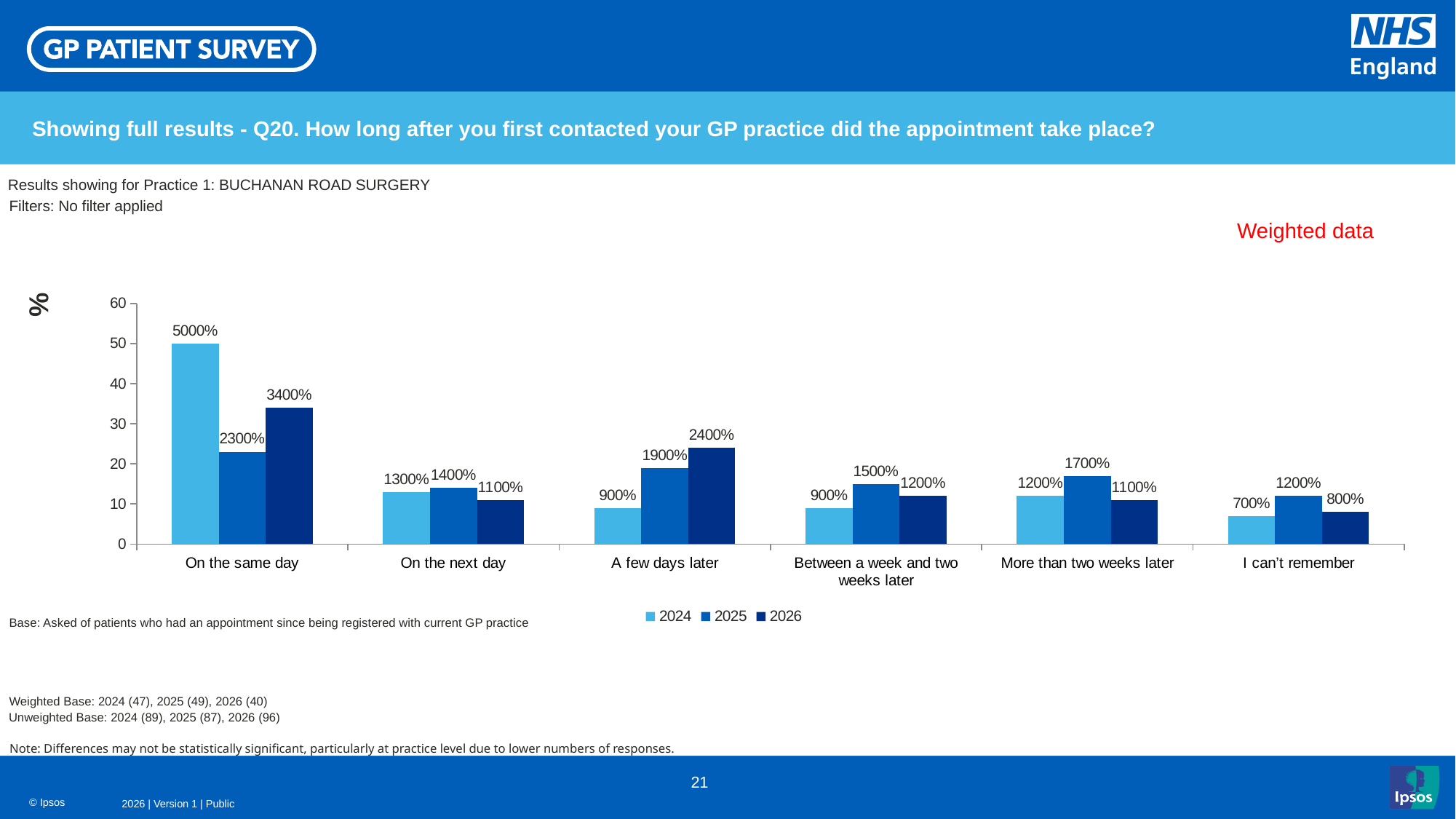
How many categories are shown on the x axis? 6 What are the legend entries of the chart? 2024, 2025, 2026 Which is larger for 'A few days later': the 2024 value or the 2025 value? 2025 What is the 2024 value for 'On the same day'? 5000% What is the 2025 value for 'More than two weeks later'? 1700% What is the 2026 value for 'A few days later'? 2400% Which category has the highest 2024 value? On the same day Which category has the lowest 2026 value? I can't remember How many series does the legend list? 3 What kind of chart is shown on the slide? Bar chart What is the difference between the 2024 and 2026 values for 'On the same day'? 1600% Do the 2026 values rise or fall from 'On the same day' to 'On the next day'? Fall